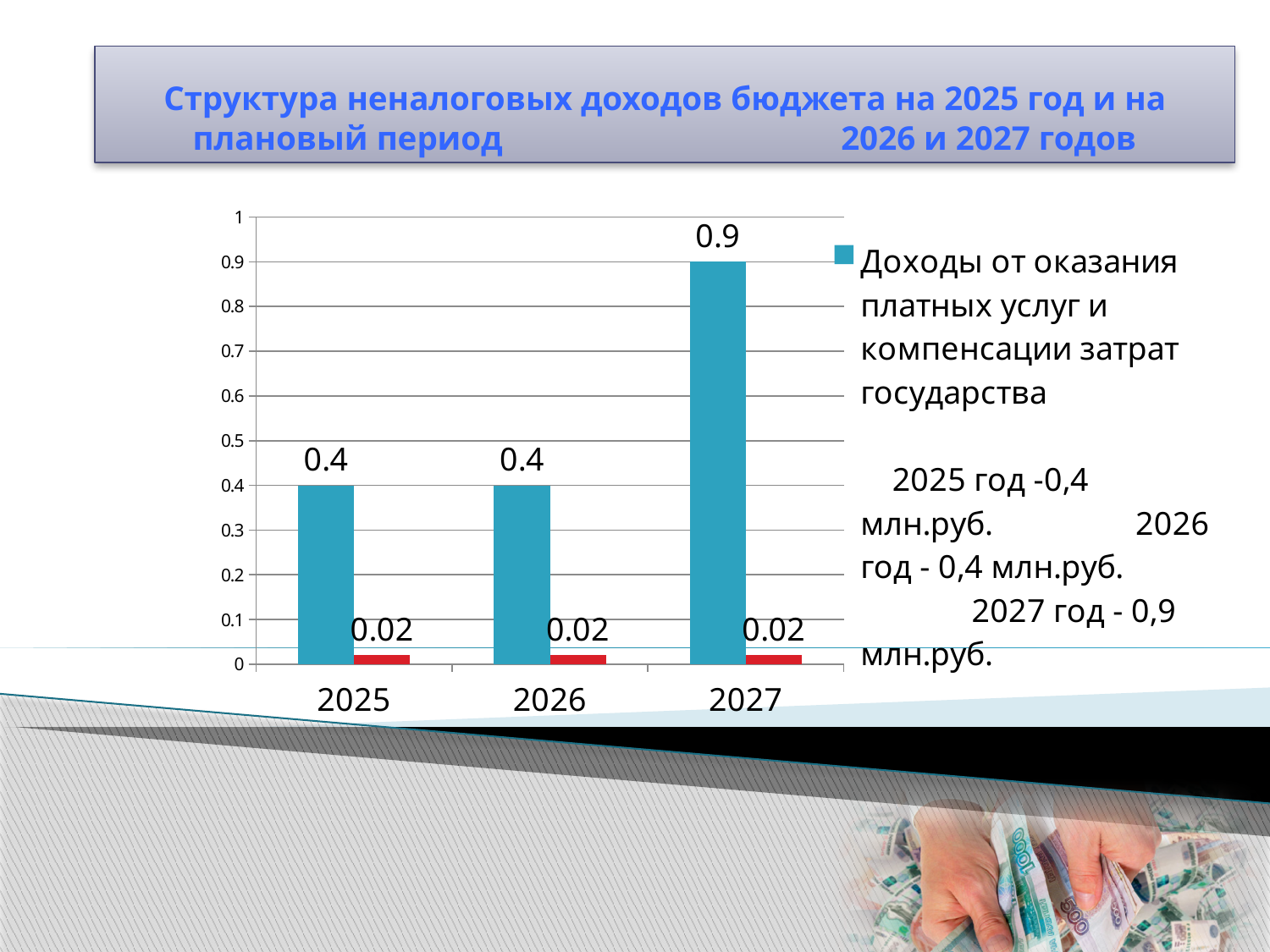
What is the value of the blue bar for 2025? 0.4 What is the value of the blue bar (Доходы от оказания платных услуг и компенсации затрат государства) for 2027? 0.9 Which is larger in 2025: the blue bar or the red bar? the blue bar Is the blue bar value for 2027 greater or less than 0.5? greater What is the maximum value shown on the vertical axis of the chart? 1 What type of chart is shown on the slide? bar chart What is the difference between the blue bar and the red bar for 2027? 0.88 How many years are shown on the x axis of the chart? 3 In which year is the blue bar (Доходы от оказания платных услуг и компенсации затрат государства) highest? 2027 Do the blue bar values rise or fall from 2025 to 2027? rise What is the difference between the blue bar values for 2027 and 2026? 0.5 What is the value of the red bar for 2026? 0.02